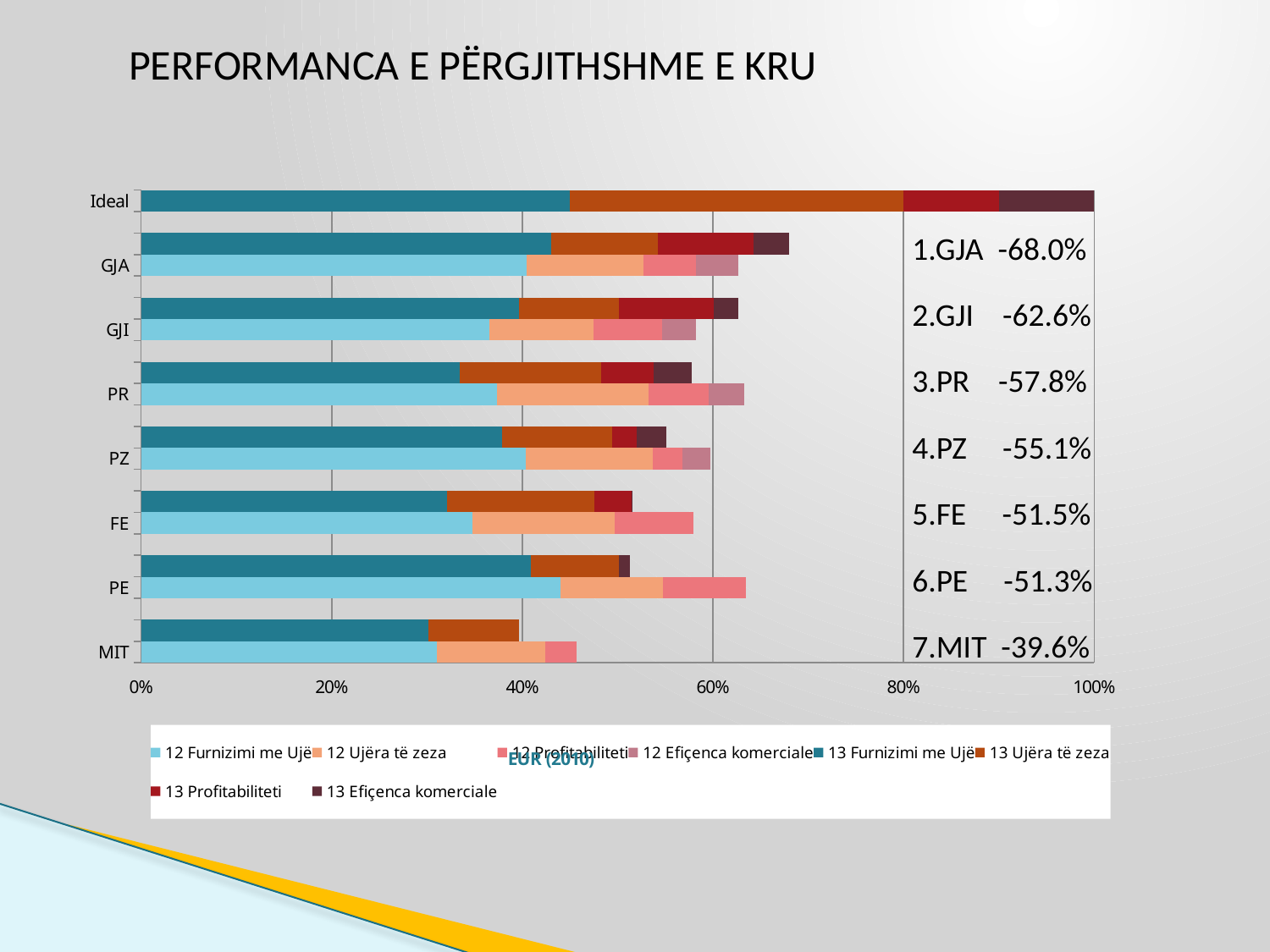
What is the title of the slide containing the chart? PERFORMANCA E PËRGJITHSHME E KRU What kind of chart is shown on the slide? Stacked bar chart How many series does the chart legend list? 8 How many categories are shown on the vertical axis of the chart? 8 What overall percentage is printed on the slide for GJA? 68.0% Excluding Ideal, which category has the shortest bars in the chart? MIT Which category has the longest bar in the chart? Ideal Is the total of the 2013 bar for MIT greater or less than 60%? less Is the total of the 2013 bar for GJA greater or less than 60%? greater What overall percentage is printed on the slide for MIT? 39.6% Which is larger, the printed overall percentage for FE or for PE? FE What overall percentage is printed on the slide for PZ? 55.1%